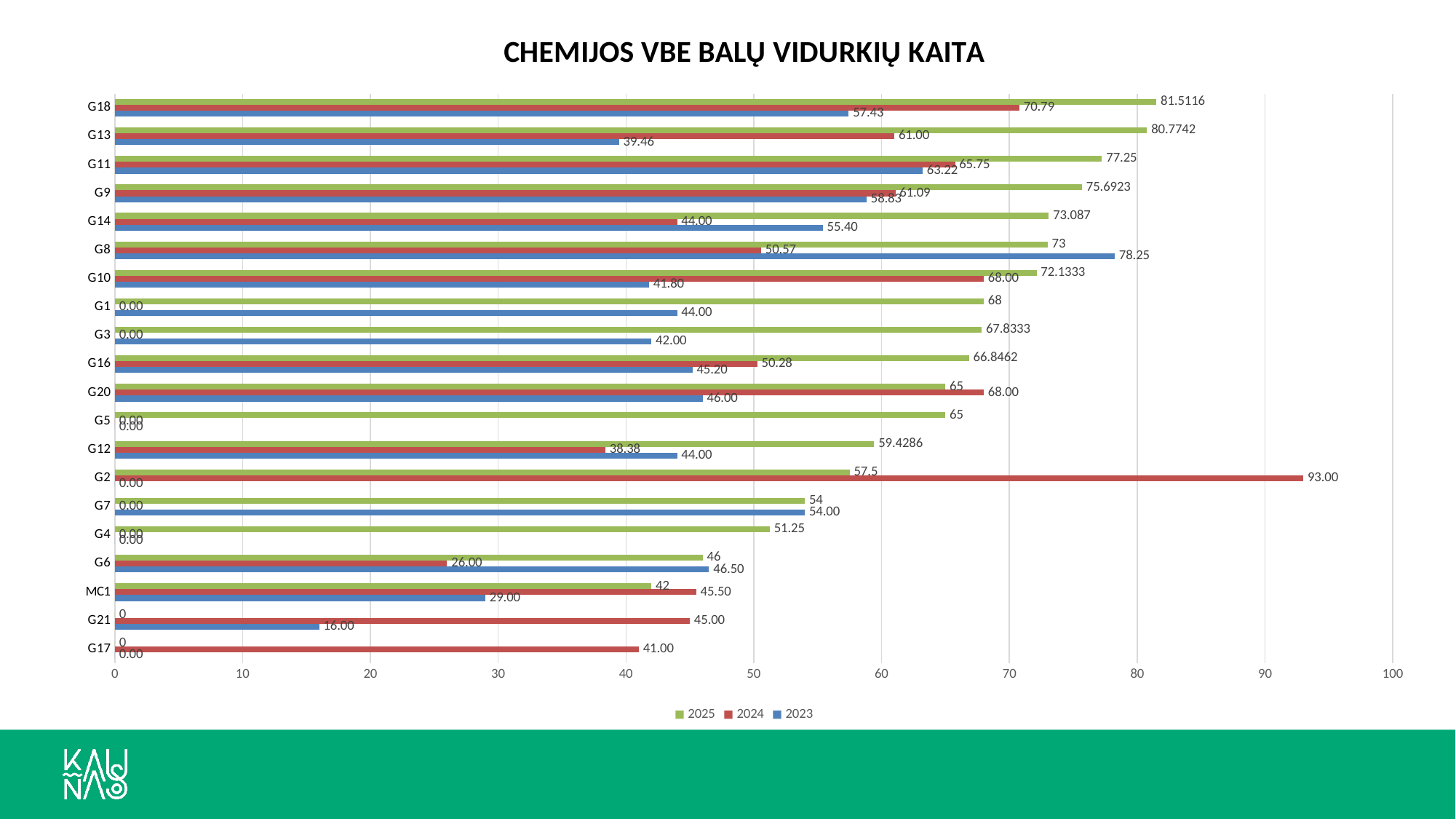
What is the 2023 value for G13? 39.46 Which category has the highest 2023 value? G8 Which is larger for G20, the 2025 value or the 2024 value? 2024 How many series does the legend list? 3 What is the difference between the 2025 and 2024 values for G14? 29.087 Which is larger for G8, the 2025 value or the 2023 value? 2023 What kind of chart is shown on the slide? Bar chart What is the 2025 value for G18? 81.5116 What is the 2024 value for G2? 93.00 Which category has the highest 2025 value? G18 How many categories are shown on the chart? 20 What is the title of the chart? CHEMIJOS VBE BALŲ VIDURKIŲ KAITA